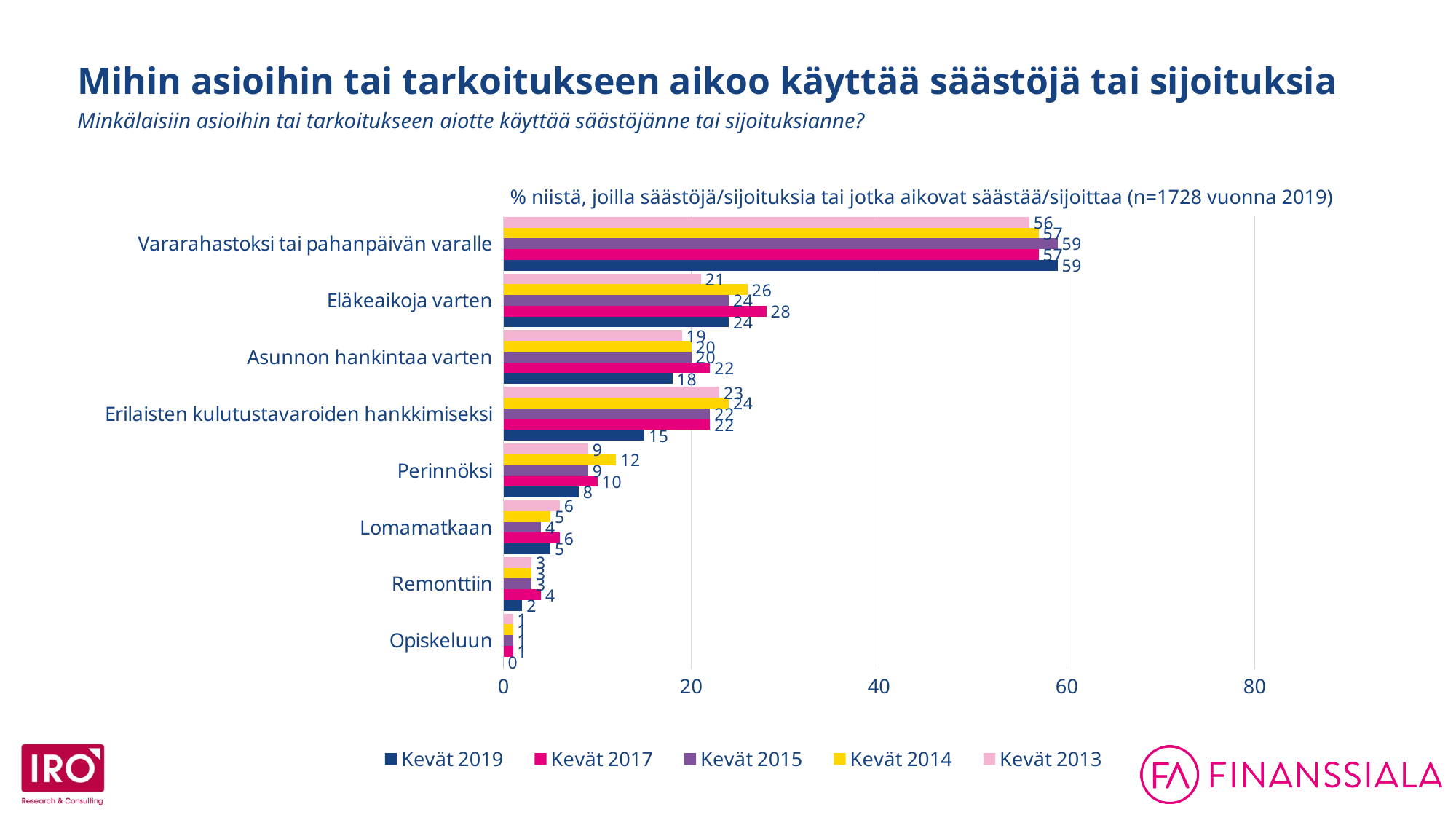
How many categories are shown on the chart? 8 What is the value for Perinnöksi in the Kevät 2014 series? 12 What is the value for Eläkeaikoja varten in the Kevät 2017 series? 28 What is the value for Erilaisten kulutustavaroiden hankkimiseksi in the Kevät 2019 series? 15 Is the Kevät 2013 value for Vararahastoksi tai pahanpäivän varalle greater or less than 40? greater Which series is shown in yellow in the legend? Kevät 2014 Which category has the lowest value in the Kevät 2019 series? Opiskeluun Which category has the highest value in the Kevät 2019 series? Vararahastoksi tai pahanpäivän varalle Which is larger for Asunnon hankintaa varten: the Kevät 2017 value or the Kevät 2019 value? Kevät 2017 What kind of chart is shown on the slide? bar chart What is the difference between the Kevät 2017 and Kevät 2019 values for Eläkeaikoja varten? 4 How many series does the legend list? 5